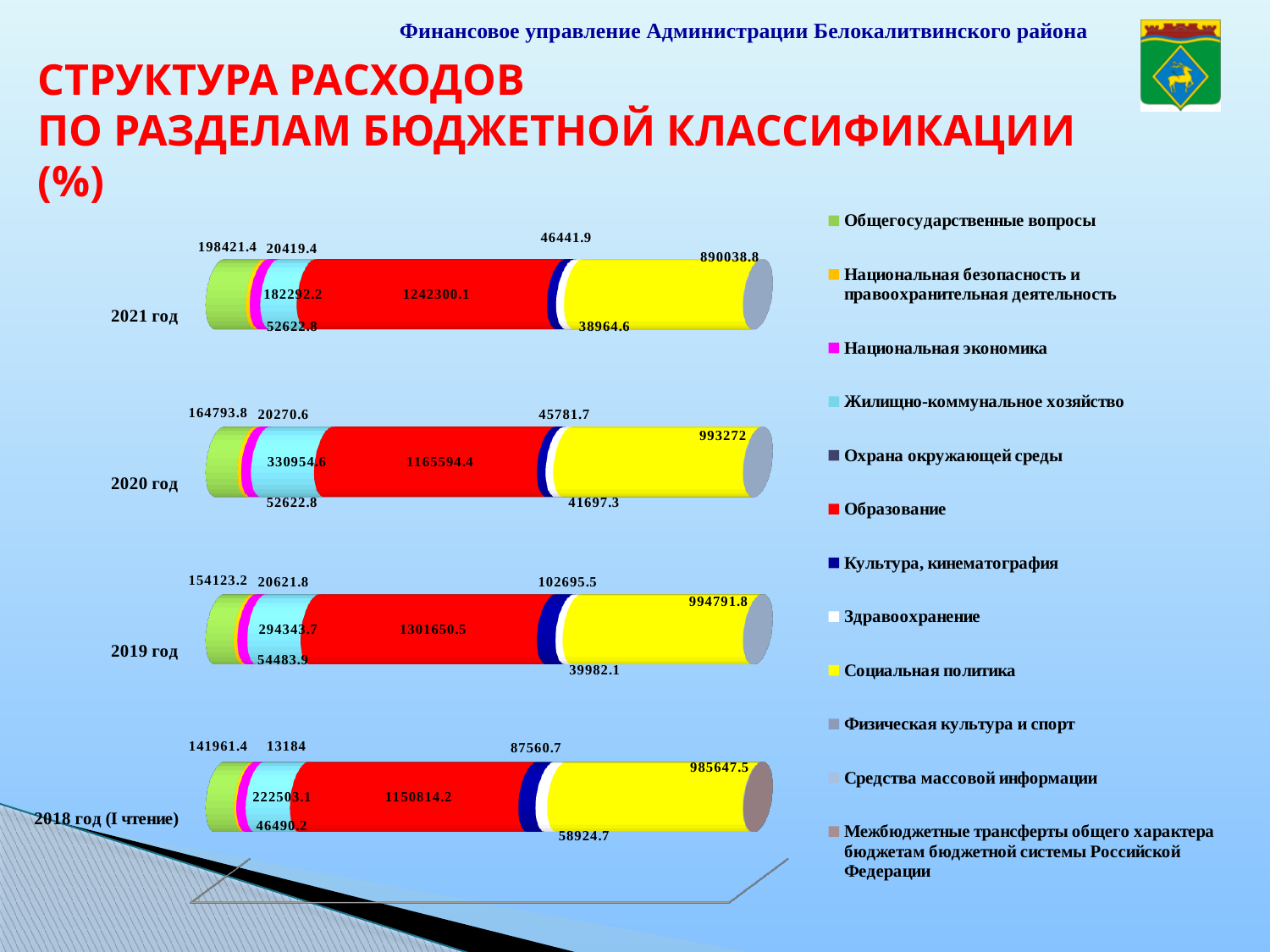
In which year is the value for Общегосударственные вопросы the lowest? 2018 год (I чтение) What kind of chart is shown on the slide? Stacked bar chart What colour represents Образование in the legend? Red What is the value for Социальная политика in 2020 год? 993272 What is the value for Общегосударственные вопросы in 2019 год? 154123.2 What is the value for Образование in 2021 год? 1242300.1 What is the value for Образование in 2018 год (I чтение)? 1150814.2 What is the difference between the Образование values for 2021 год and 2020 год? 76705.7 Which year has the larger value for Образование, 2021 год or 2020 год? 2021 год How many years (categories) are plotted in the chart? 4 How many series does the legend list? 12 In which year is the value for Образование the highest? 2019 год